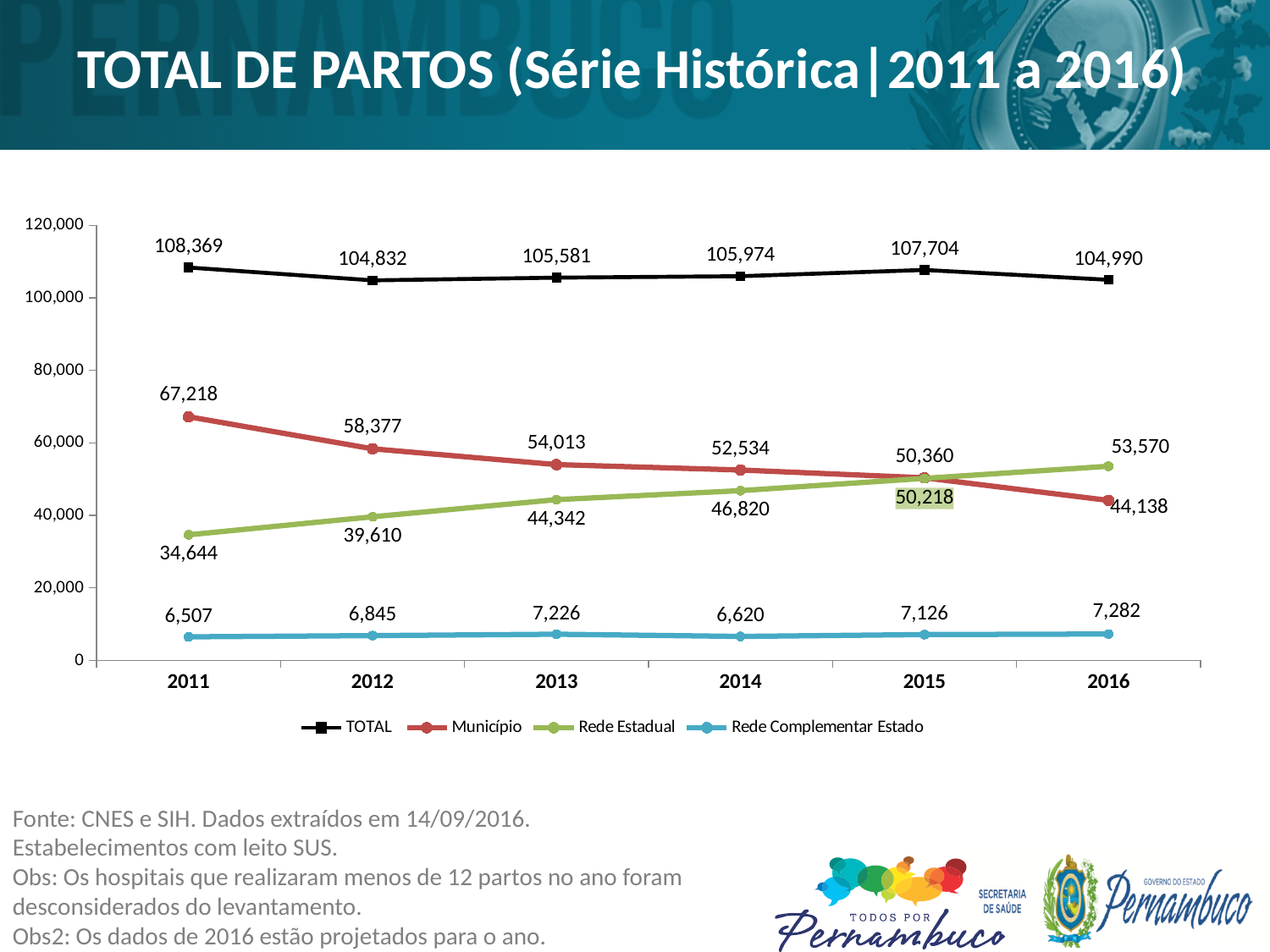
What is the difference between the Município values for 2011 and 2016? 23,080 How many series does the legend list? 4 In which year is the TOTAL series at its highest? 2011 What is the TOTAL value for 2011? 108,369 What type of chart is shown on the slide? line chart What is the value for Rede Complementar Estado in 2014? 6,620 Which is larger in 2016, Município or Rede Estadual? Rede Estadual In which year is the Município series at its lowest? 2016 Does the Rede Estadual series rise or fall from 2011 to 2016? rise How many years are plotted along the x axis? 6 What is the title of the chart on the slide? TOTAL DE PARTOS (Série Histórica|2011 a 2016) What is the value for Rede Estadual in 2016? 53,570